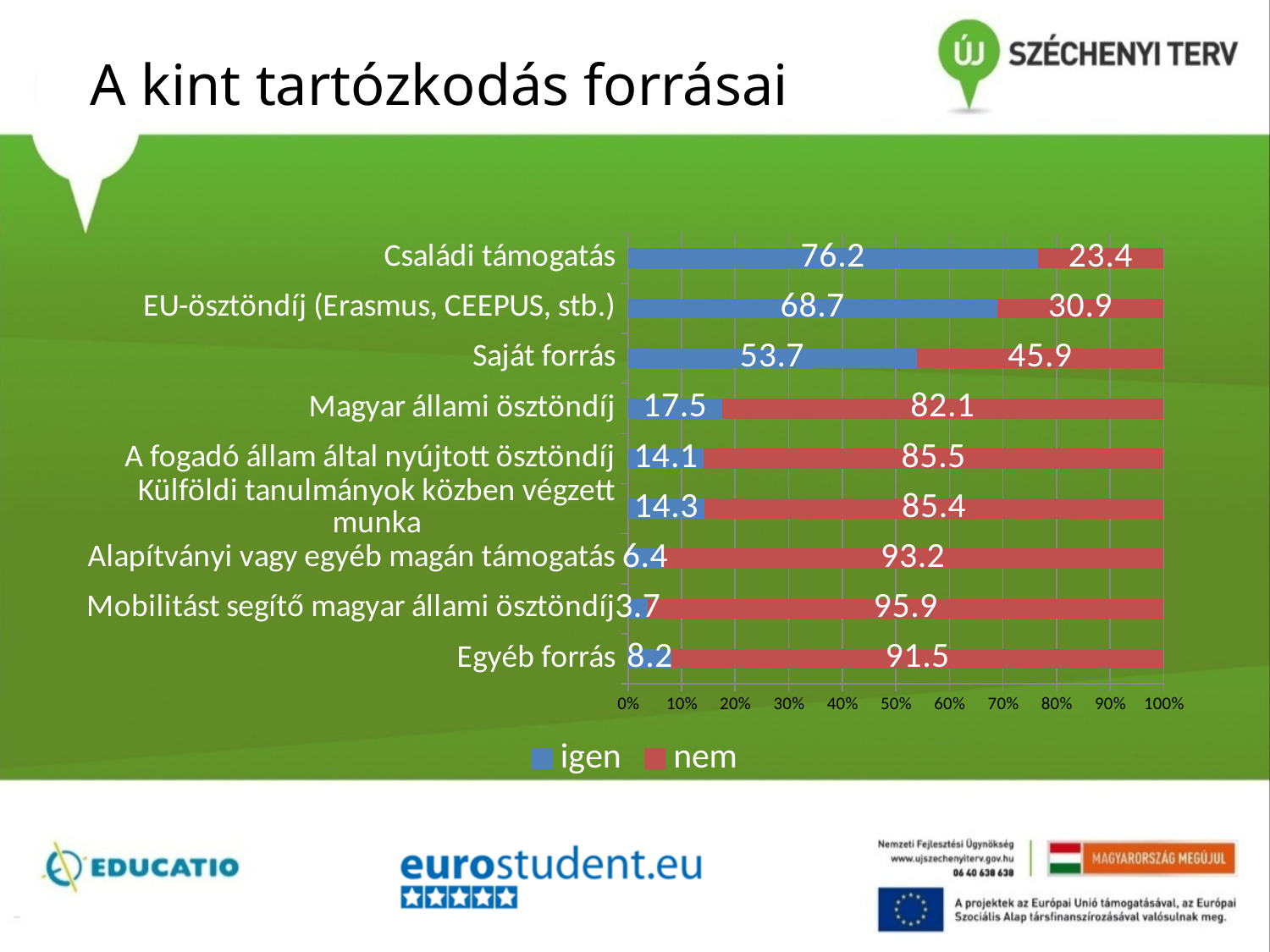
What is the total of the 'igen' and 'nem' values for Családi támogatás? 99.6 For Saját forrás, which is larger, the 'igen' value or the 'nem' value? igen What is the 'igen' value for Magyar állami ösztöndíj? 17.5 Which category has the highest 'igen' value? Családi támogatás Which category has the lowest 'igen' value? Mobilitást segítő magyar állami ösztöndíj Which category has the highest 'nem' value? Mobilitást segítő magyar állami ösztöndíj What kind of chart is shown on the slide? Stacked bar chart How many categories are shown in the chart? 9 What is the 'nem' value for Saját forrás? 45.9 What is the difference between the 'igen' values for Családi támogatás and EU-ösztöndíj (Erasmus, CEEPUS, stb.)? 7.5 How many series does the legend list? 2 What is the 'igen' value for Családi támogatás? 76.2